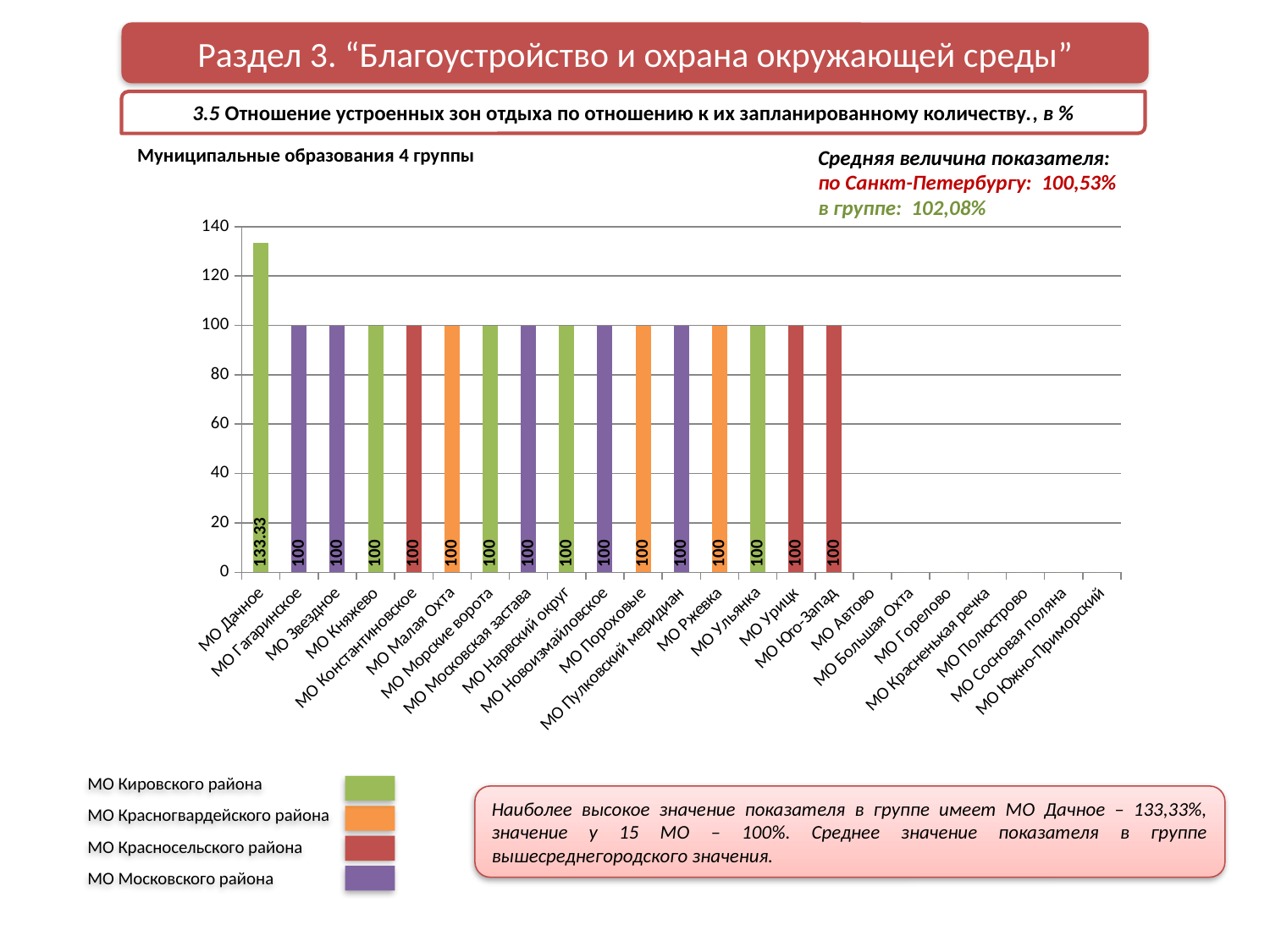
What is the difference between the values for МО Дачное and МО Гагаринское? 33.33 What is the highest tick value shown on the vertical axis? 140 Which category has the highest value? МО Дачное How many bars show a value of 100? 15 Which district's municipalities are shown in green according to the colour key? МО Кировского района What is the value for МО Ульянка? 100 Is the value for МО Дачное greater or less than 120? greater Which is larger, the value for МО Дачное or the value for МО Ржевка? МО Дачное What is the value for МО Пороховые? 100 What kind of chart is shown on the slide? bar chart What is the value for МО Дачное? 133.33 How many categories are listed on the x axis? 23